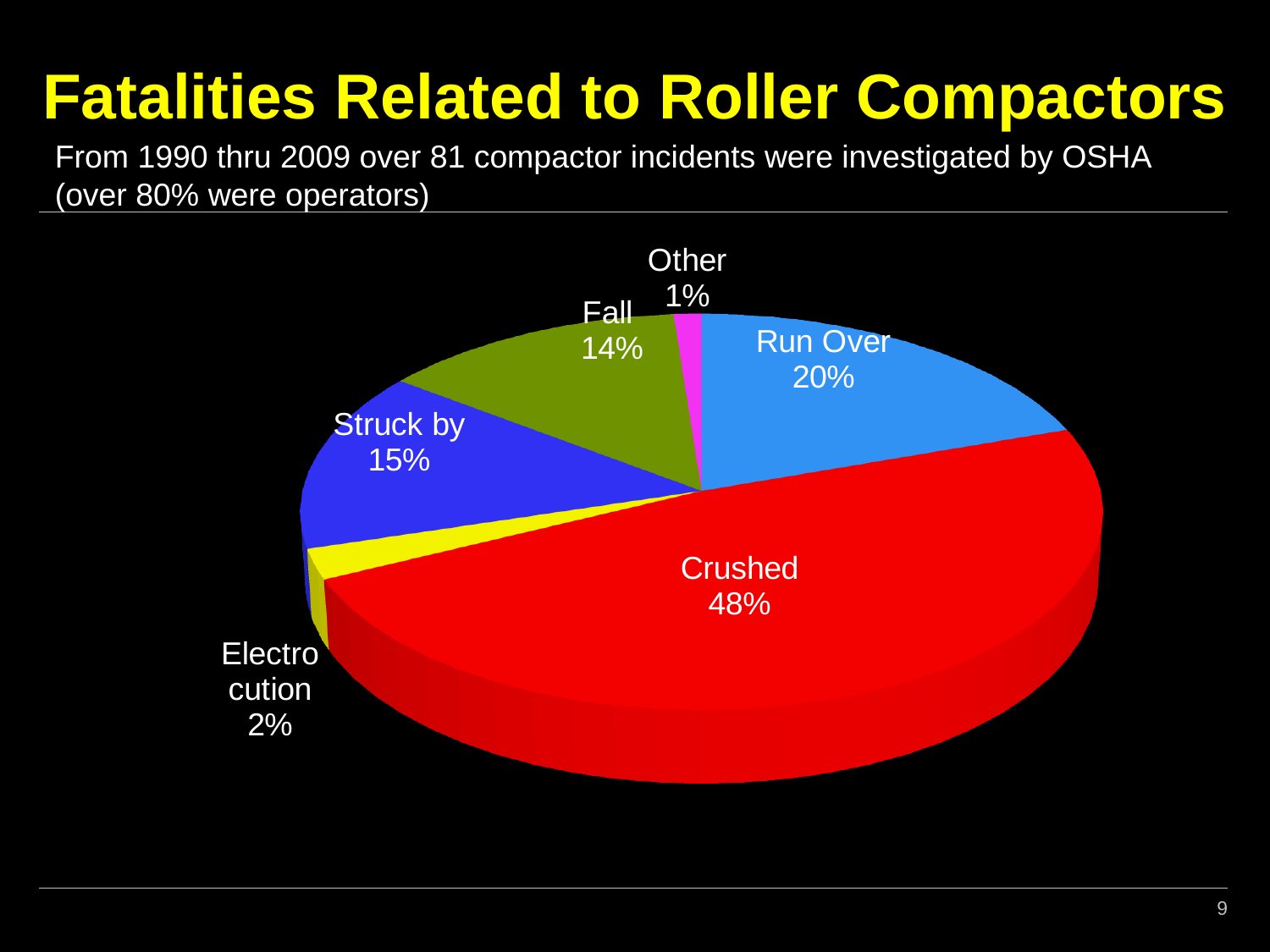
Which category has the largest share of the pie? Crushed How many categories are shown in the pie chart? 6 What share of fatalities is attributed to Electrocution? 2% What share of the pie is Struck by? 15% What is the difference in percentage points between Crushed and Run Over? 28 What kind of chart is shown on the slide? Pie chart Which category has the smallest share of the pie? Other What percentage is shown for Fall? 14% Which is larger, the share for Struck by or the share for Fall? Struck by What colour is the Crushed slice? Red What percentage of fatalities is labelled Run Over? 20% What share of fatalities is attributed to Crushed? 48%